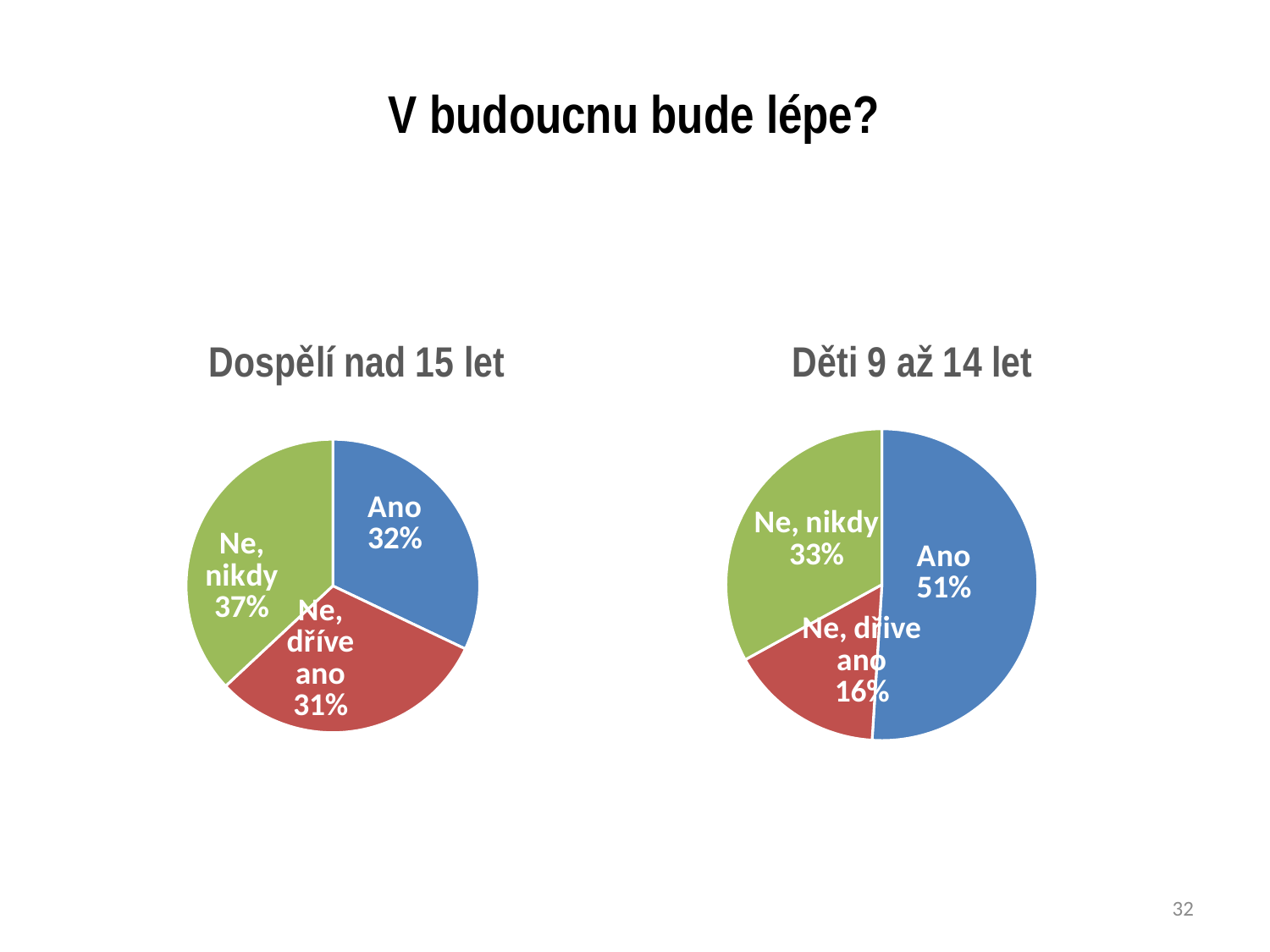
What is the difference between the "Ano" share in the "Děti 9 až 14 let" chart and the "Ano" share in the "Dospělí nad 15 let" chart? 19 percentage points In the "Děti 9 až 14 let" chart, which category has the smallest slice? Ne, dříve ano In the "Děti 9 až 14 let" chart, what is the value for "Ne, nikdy"? 33% In the "Dospělí nad 15 let" chart, what is the value for "Ne, nikdy"? 37% Which is larger: "Ne, nikdy" in the "Dospělí nad 15 let" chart or "Ne, nikdy" in the "Děti 9 až 14 let" chart? Dospělí nad 15 let In the "Děti 9 až 14 let" chart, what share of the pie is "Ano"? 51% In the "Dospělí nad 15 let" chart, what share of the pie is "Ano"? 32% In the "Děti 9 až 14 let" chart, what is the value for "Ne, dříve ano"? 16% What type of chart is used for "Dospělí nad 15 let"? Pie chart How many slices does the "Děti 9 až 14 let" chart have? 3 In the "Dospělí nad 15 let" chart, what is the value for "Ne, dříve ano"? 31% In the "Dospělí nad 15 let" chart, which category has the largest slice? Ne, nikdy